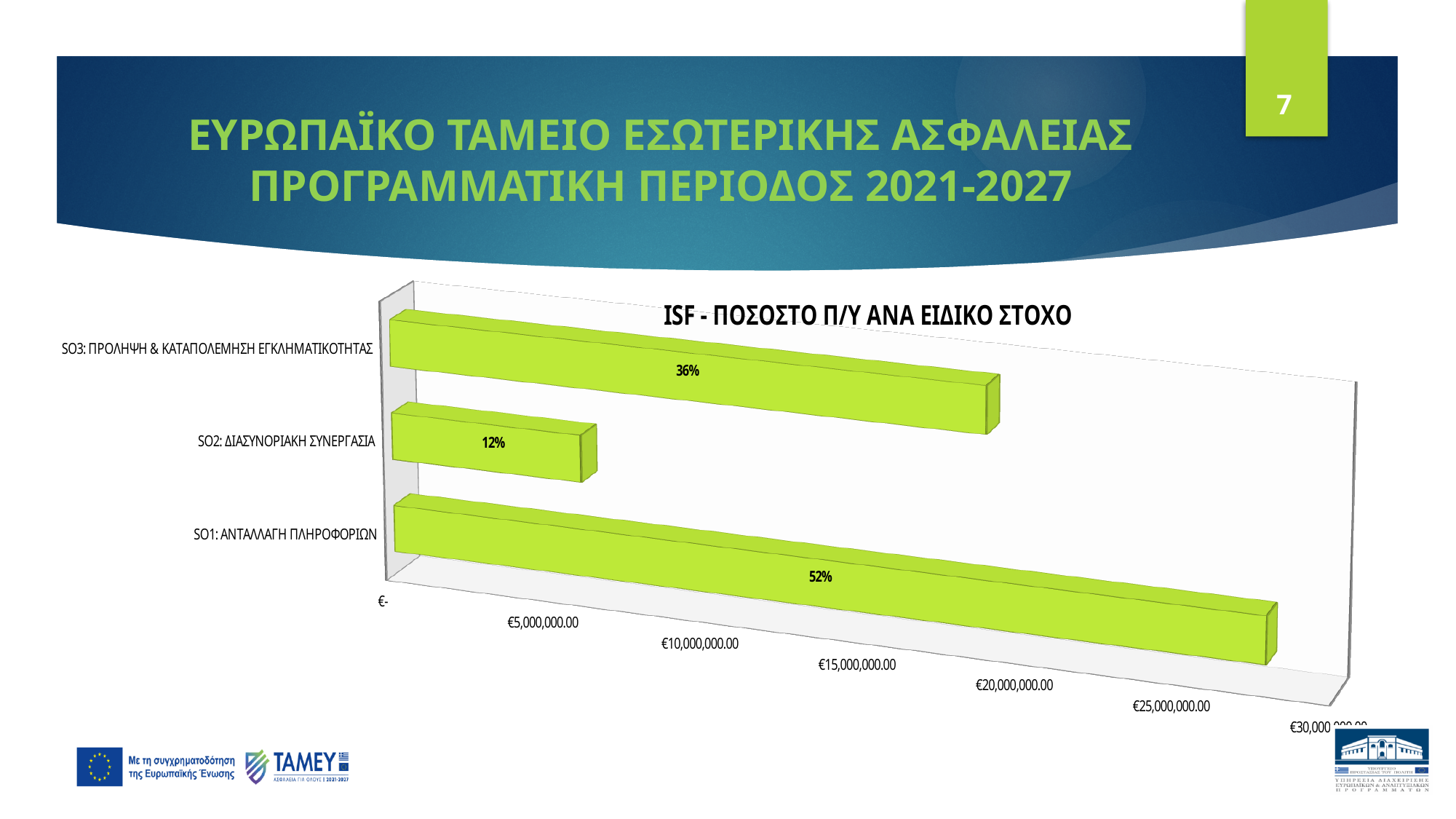
What data label is shown on the bar for SO1: ΑΝΤΑΛΛΑΓΗ ΠΛΗΡΟΦΟΡΙΩΝ? 52% What is the difference in percentage points between the labels for SO3 and SO2? 24% Which specific objective has the highest share of the budget? SO1: ΑΝΤΑΛΛΑΓΗ ΠΛΗΡΟΦΟΡΙΩΝ What data label is shown on the bar for SO2: ΔΙΑΣΥΝΟΡΙΑΚΗ ΣΥΝΕΡΓΑΣΙΑ? 12% Which specific objective has the lowest share of the budget? SO2: ΔΙΑΣΥΝΟΡΙΑΚΗ ΣΥΝΕΡΓΑΣΙΑ How many specific objectives (categories) are plotted in the chart? 3 Is the value for SO2: ΔΙΑΣΥΝΟΡΙΑΚΗ ΣΥΝΕΡΓΑΣΙΑ greater or less than €10,000,000.00? less What is the difference in percentage points between the labels for SO1 and SO3? 16% Is the value for SO1: ΑΝΤΑΛΛΑΓΗ ΠΛΗΡΟΦΟΡΙΩΝ greater or less than €15,000,000.00? greater What data label is shown on the bar for SO3: ΠΡΟΛΗΨΗ & ΚΑΤΑΠΟΛΕΜΗΣΗ ΕΓΚΛΗΜΑΤΙΚΟΤΗΤΑΣ? 36% What type of chart is shown on the slide? Bar chart Which has a larger share, SO3 or SO2? SO3: ΠΡΟΛΗΨΗ & ΚΑΤΑΠΟΛΕΜΗΣΗ ΕΓΚΛΗΜΑΤΙΚΟΤΗΤΑΣ